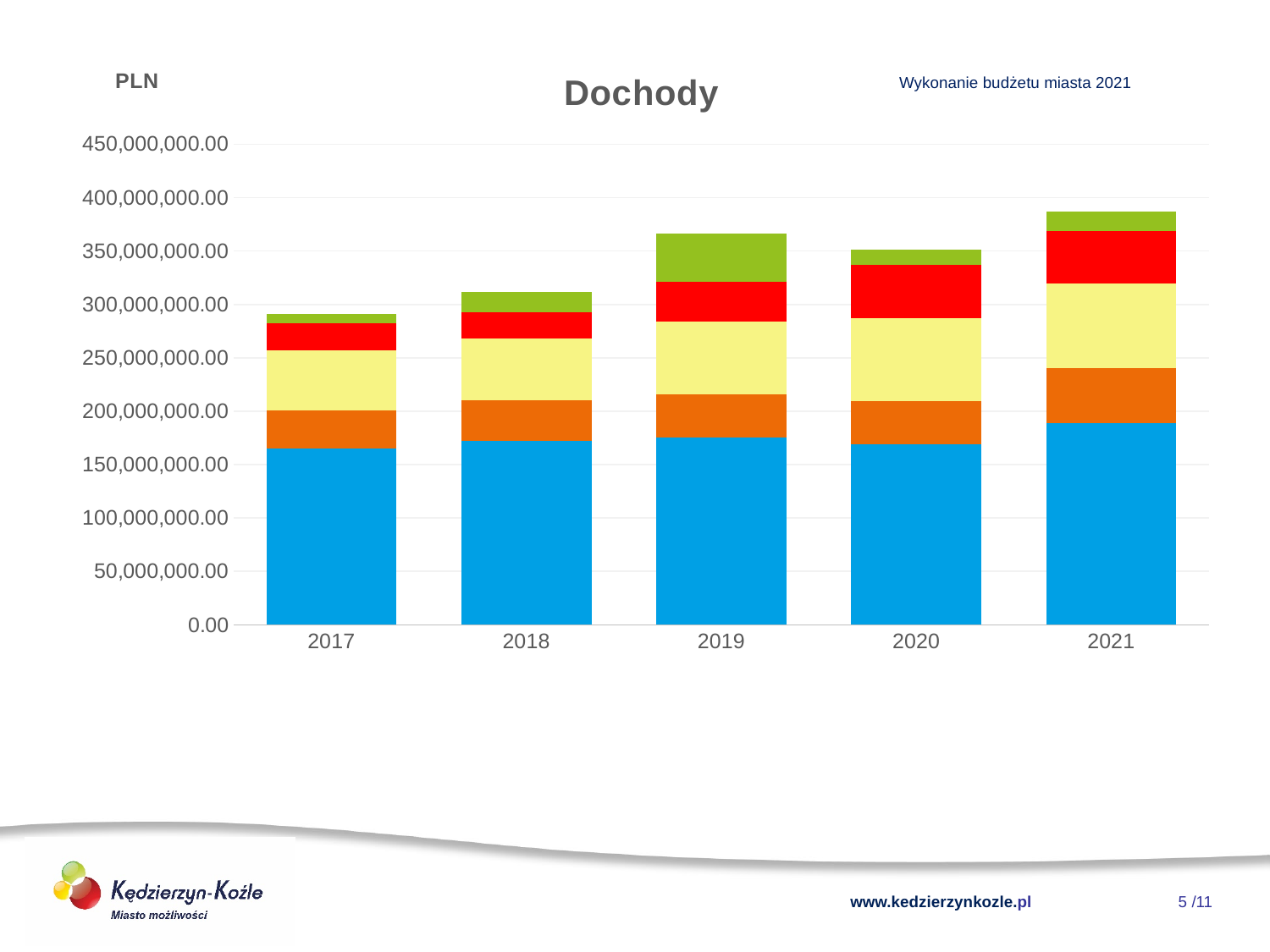
Is the total height of the 2019 bar greater or less than 350,000,000.00? greater Is the total height of the 2018 bar greater or less than 300,000,000.00? greater What unit label is shown above the vertical axis of the chart? PLN Is the total height of the 2017 bar greater or less than 300,000,000.00? less What is the title of the chart? Dochody Which year has the tallest stacked bar in the chart? 2021 Which bar is taller in total, 2019 or 2020? 2019 How many years (bars) are shown on the x axis of the chart? 5 What kind of chart is shown on the slide? Stacked bar chart Which year has the shortest stacked bar in the chart? 2017 Which bar is taller in total, 2017 or 2018? 2018